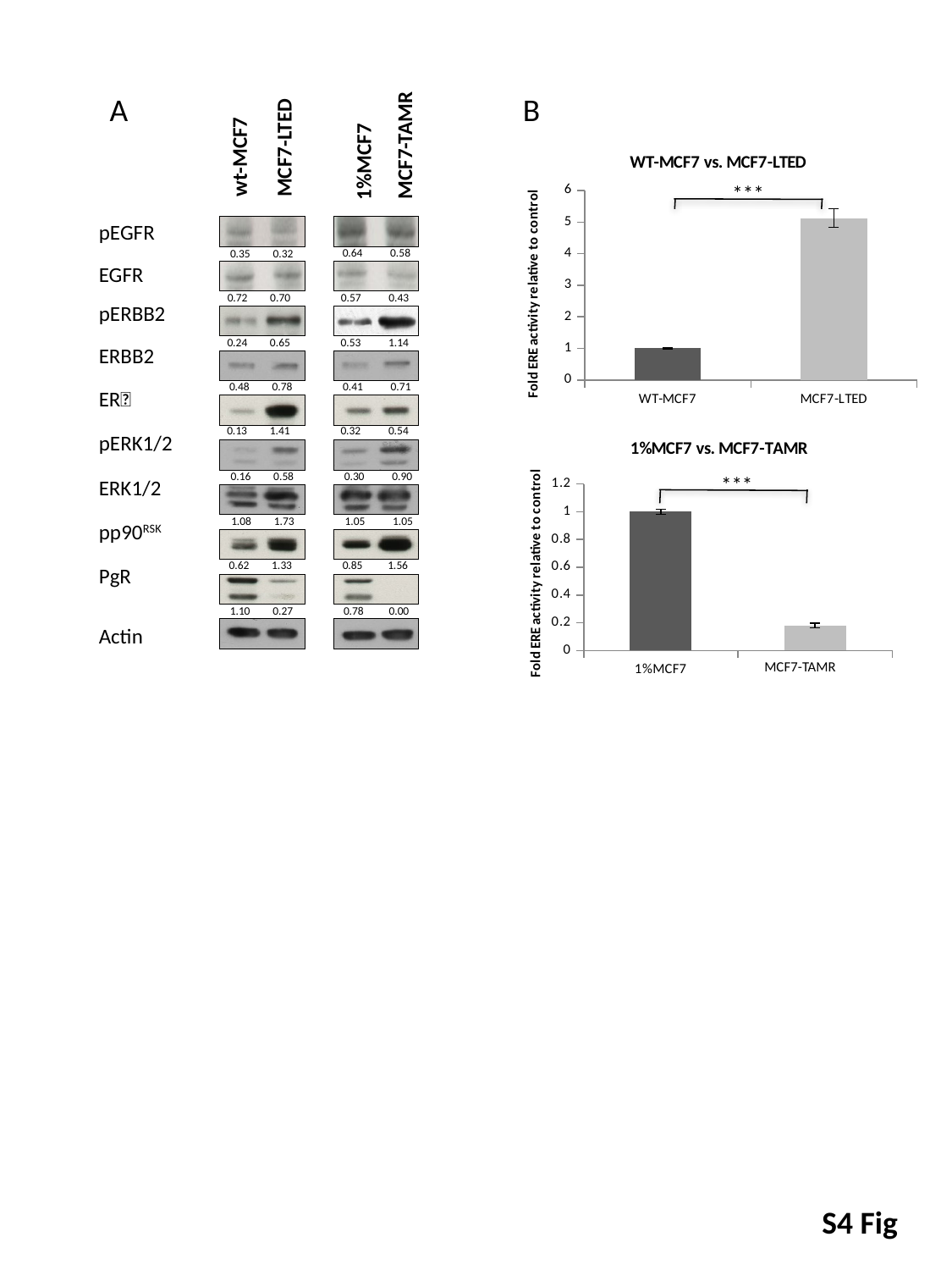
In the chart titled 'WT-MCF7 vs. MCF7-LTED', what kind of chart is shown? bar chart In the chart titled '1%MCF7 vs. MCF7-TAMR', what is the value for 1%MCF7? 1 In the chart titled 'WT-MCF7 vs. MCF7-LTED', what is the y-axis label? Fold ERE activity relative to control In the chart titled '1%MCF7 vs. MCF7-TAMR', is the value for MCF7-TAMR greater or less than 0.4? less In the chart titled '1%MCF7 vs. MCF7-TAMR', which is larger, the value for 1%MCF7 or the value for MCF7-TAMR? 1%MCF7 In the chart titled 'WT-MCF7 vs. MCF7-LTED', which category has the highest value? MCF7-LTED In the chart titled '1%MCF7 vs. MCF7-TAMR', what is the highest value shown on the y axis? 1.2 In the chart titled 'WT-MCF7 vs. MCF7-LTED', what is the value for WT-MCF7? 1 In the chart titled 'WT-MCF7 vs. MCF7-LTED', is the value for MCF7-LTED greater or less than 4? greater In the chart titled '1%MCF7 vs. MCF7-TAMR', how many bars are plotted? 2 In the chart titled 'WT-MCF7 vs. MCF7-LTED', how many categories are plotted? 2 In the chart titled '1%MCF7 vs. MCF7-TAMR', which category has the lowest value? MCF7-TAMR